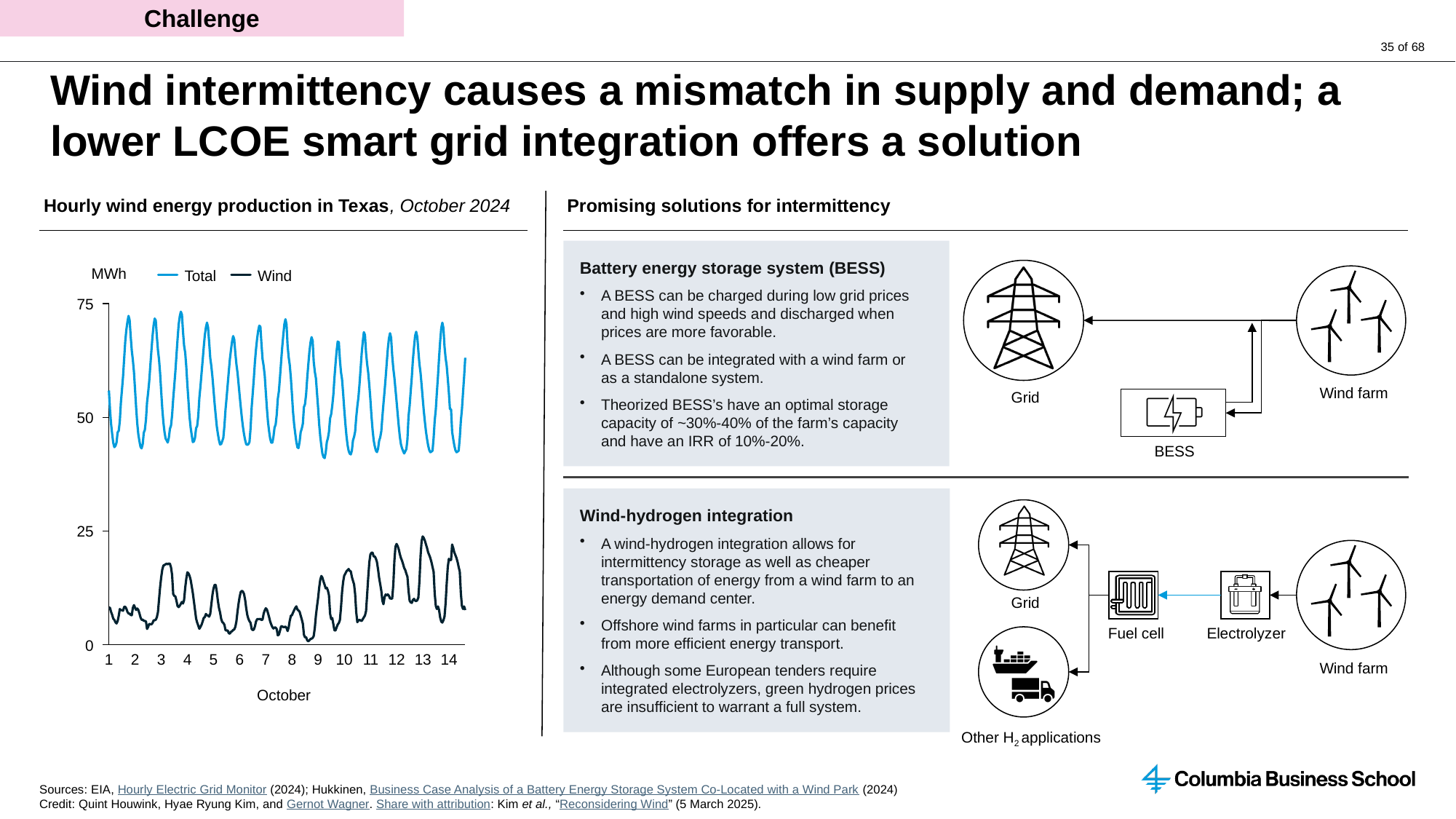
What are the two series named in the legend of the hourly wind energy production chart? Total and Wind What type of chart is used to show hourly wind energy production in Texas? Line chart In the hourly wind energy production chart, do the peaks of the Wind series generally rise or fall from day 1 to day 14? rise In the hourly wind energy production chart, is the highest value of the Wind series greater or less than 25? less In the hourly wind energy production chart, which series has higher values throughout, Total or Wind? Total How many days are labeled on the x axis of the hourly wind energy production chart? 14 What unit is shown on the y axis of the hourly wind energy production chart? MWh In the hourly wind energy production chart, is the lowest value of the Total series greater or less than 25? greater In the hourly wind energy production chart, is the highest value of the Total series greater or less than 50? greater How many series does the legend of the hourly wind energy production chart list? 2